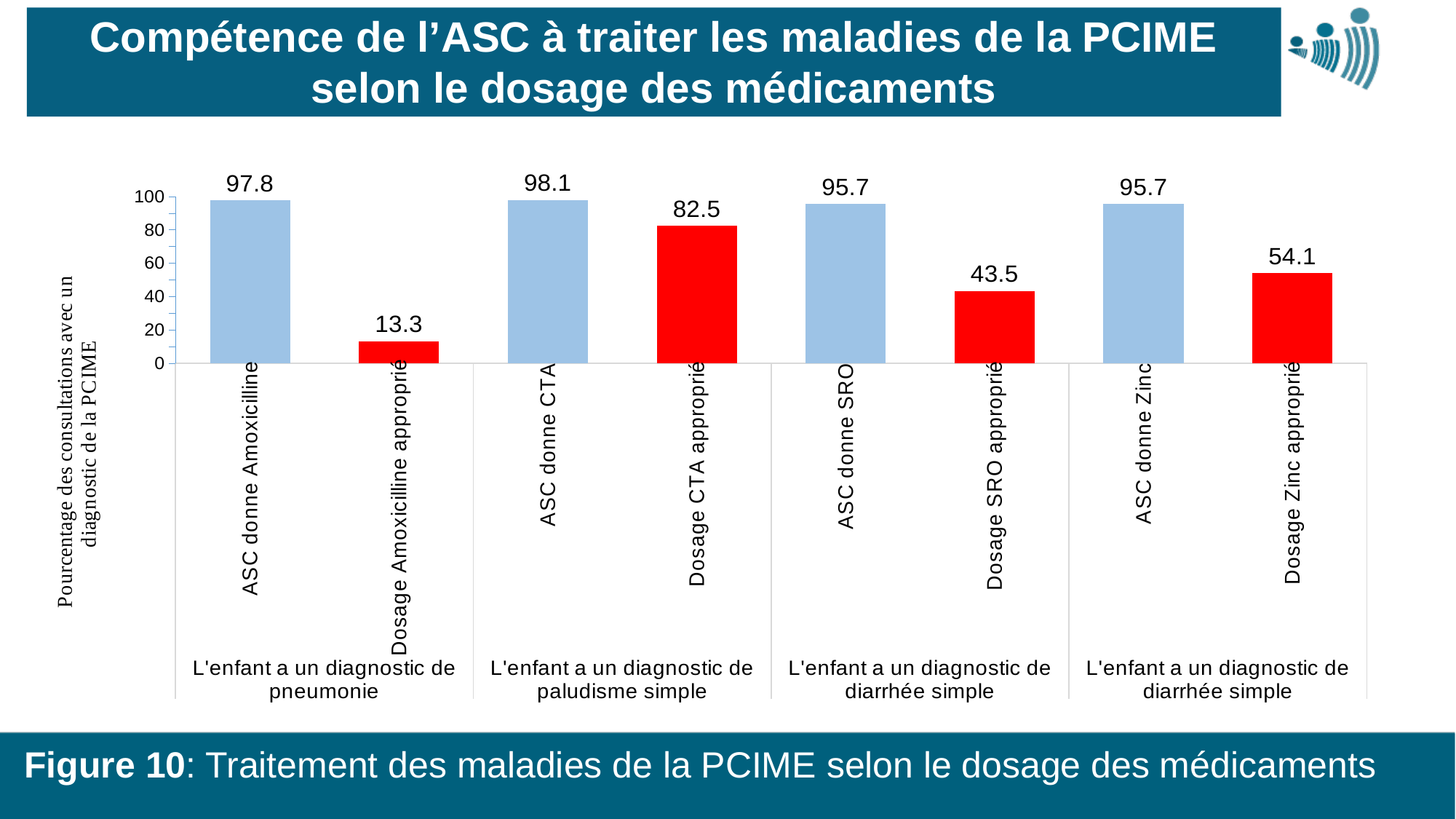
What kind of chart is shown on the slide? Bar chart What is the value for 'Dosage Amoxicilline approprié'? 13.3 Which is larger, 'Dosage CTA approprié' or 'Dosage Zinc approprié'? Dosage CTA approprié What is the value for 'Dosage SRO approprié'? 43.5 What is the difference between 'ASC donne SRO' and 'Dosage SRO approprié'? 52.2 What is the difference between 'ASC donne Amoxicilline' and 'Dosage Amoxicilline approprié'? 84.5 Which bar has the highest value? ASC donne CTA Which bar has the lowest value? Dosage Amoxicilline approprié How many bars are plotted in the chart? 8 What is the value for 'Dosage CTA approprié'? 82.5 What is the value for 'ASC donne Amoxicilline'? 97.8 What is the value for 'Dosage Zinc approprié'? 54.1